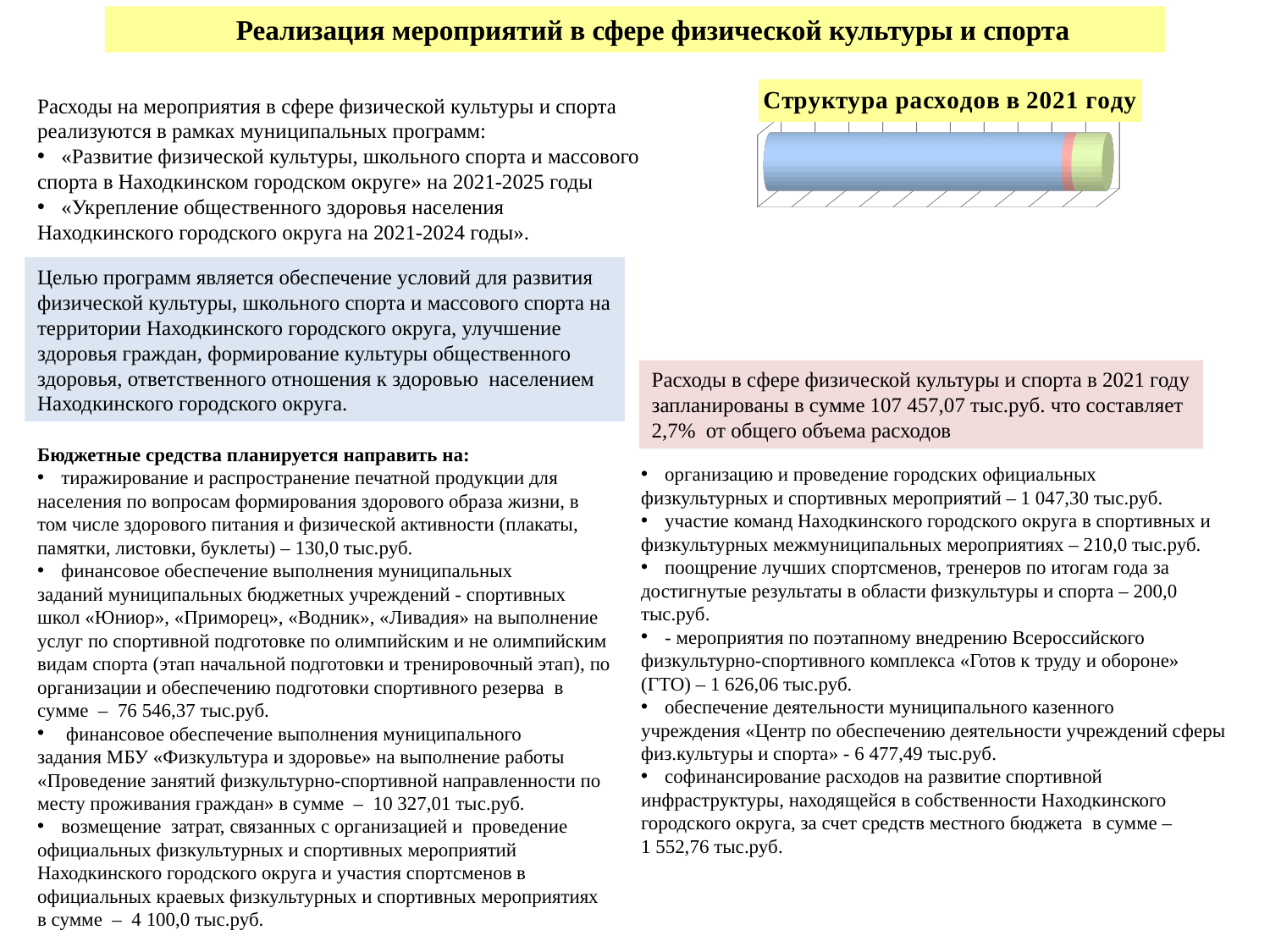
What kind of chart is shown under the title "Структура расходов в 2021 году"? bar chart What is the title of the chart on the slide? Структура расходов в 2021 году In the chart "Структура расходов в 2021 году", which coloured segment is the largest? the blue segment In the chart "Структура расходов в 2021 году", is the bar oriented horizontally or vertically? horizontally In the chart "Структура расходов в 2021 году", is the blue segment larger or smaller than the green segment? larger How many coloured segments make up the bar in the chart "Структура расходов в 2021 году"? 3